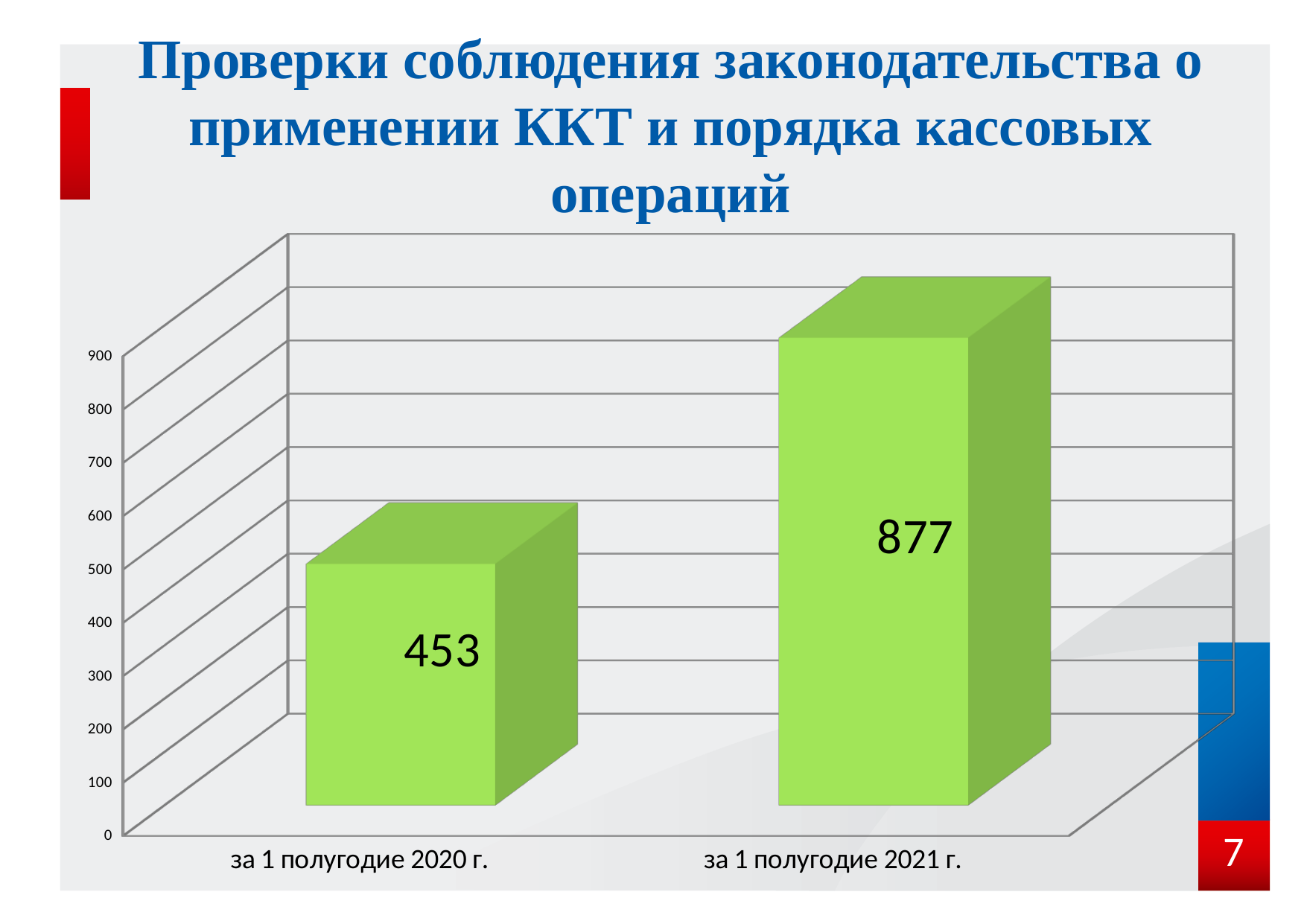
What kind of chart is shown on the slide? bar chart What is the value for за 1 полугодие 2021 г.? 877 Is the value for за 1 полугодие 2020 г. greater or less than 500? less What is the difference between the values for за 1 полугодие 2021 г. and за 1 полугодие 2020 г.? 424 Is the value for за 1 полугодие 2021 г. greater or less than 800? greater Which category has the highest value? за 1 полугодие 2021 г. Do the values rise or fall from за 1 полугодие 2020 г. to за 1 полугодие 2021 г.? rise Which category has the lowest value? за 1 полугодие 2020 г. What is the value for за 1 полугодие 2020 г.? 453 What colour are the bars on the chart? green How many categories are shown on the chart? 2 Which is larger: the value for за 1 полугодие 2020 г. or за 1 полугодие 2021 г.? за 1 полугодие 2021 г.